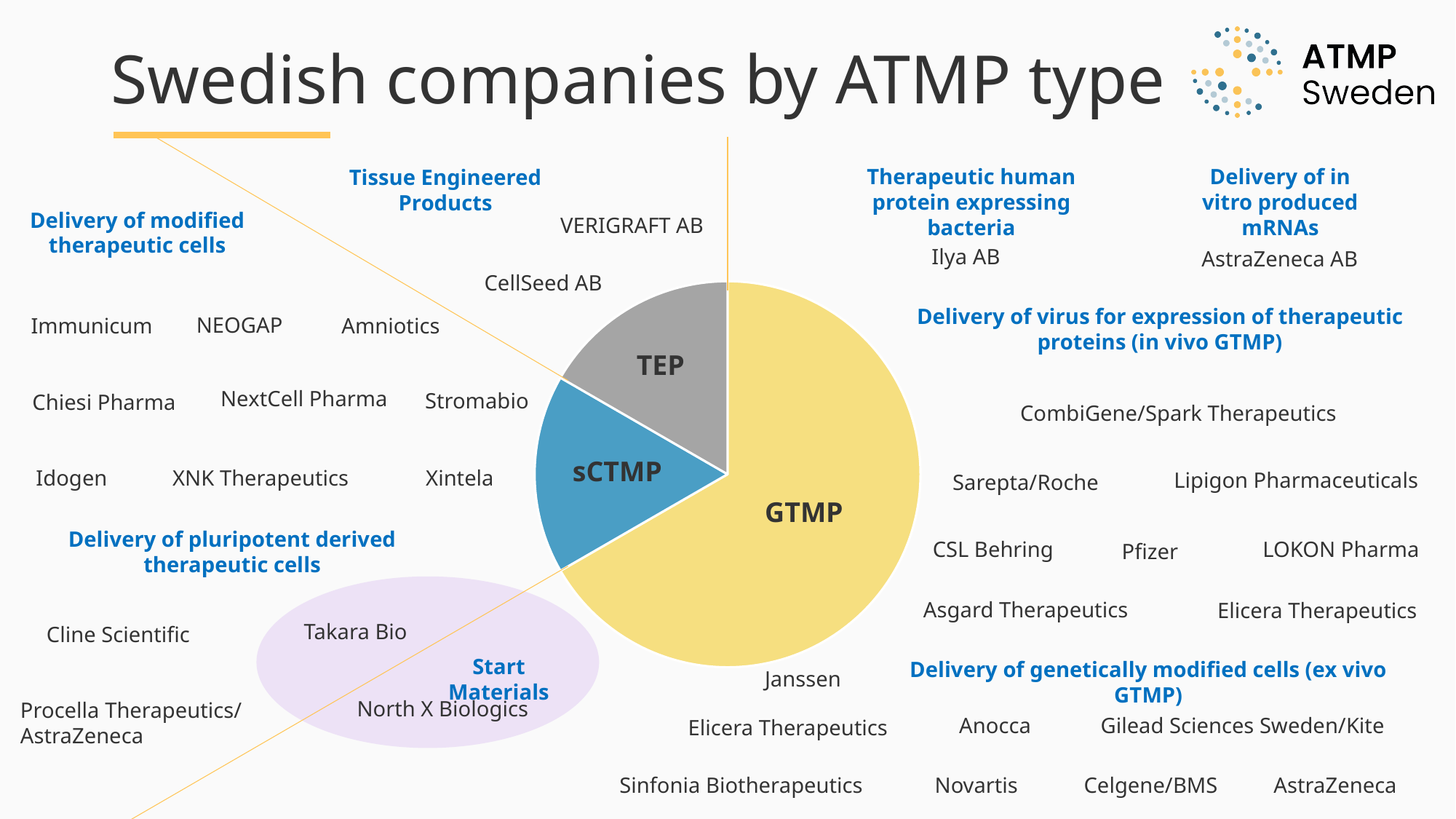
How many slices does the pie chart have? 3 Which slice of the pie chart is coloured blue? sCTMP Which is larger in the pie chart, GTMP or sCTMP? GTMP Which slice of the pie chart is coloured grey? TEP What is the title of the slide containing the pie chart? Swedish companies by ATMP type Which ATMP type has the largest slice in the pie chart? GTMP What colour is the GTMP slice of the pie chart? yellow What kind of chart is shown on the slide? pie chart Which is larger in the pie chart, GTMP or TEP? GTMP